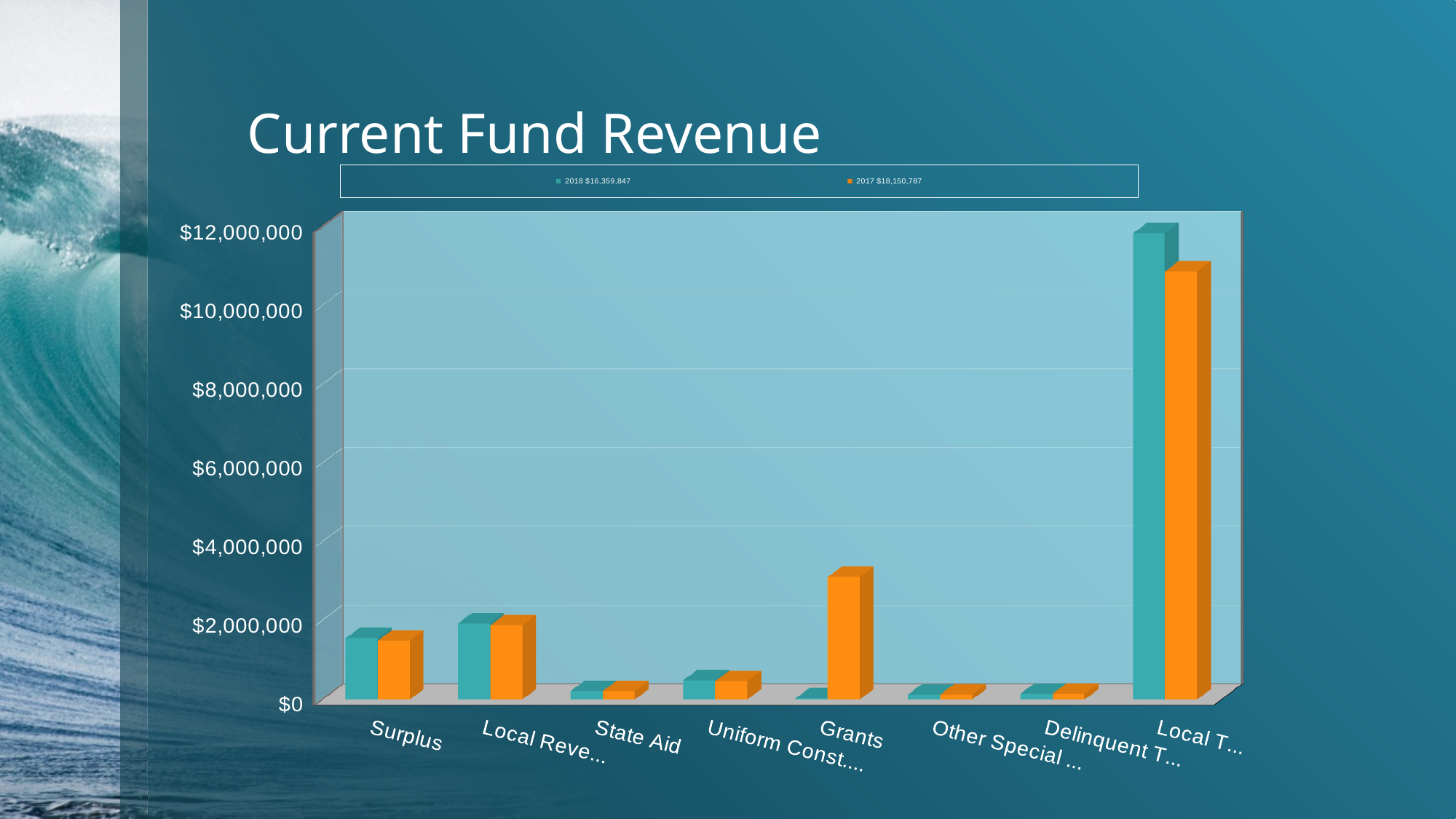
Which category has the highest value for the 2017 series? Local T... (the rightmost category) Is the 2017 value for Grants greater or less than $2,000,000? greater Which colour represents the 2017 series? orange What is the title of the chart? Current Fund Revenue Is the 2018 value for the rightmost category greater or less than $10,000,000? greater How many series does the legend list? 2 Is the 2018 value for Surplus greater or less than $2,000,000? less For the rightmost category, which series has the larger value, 2018 or 2017? 2018 Which category has the highest value for the 2018 series? Local T... (the rightmost category) How many categories are shown on the x axis? 8 What kind of chart is shown on the slide? bar chart For Grants, which series has the larger value, 2018 or 2017? 2017